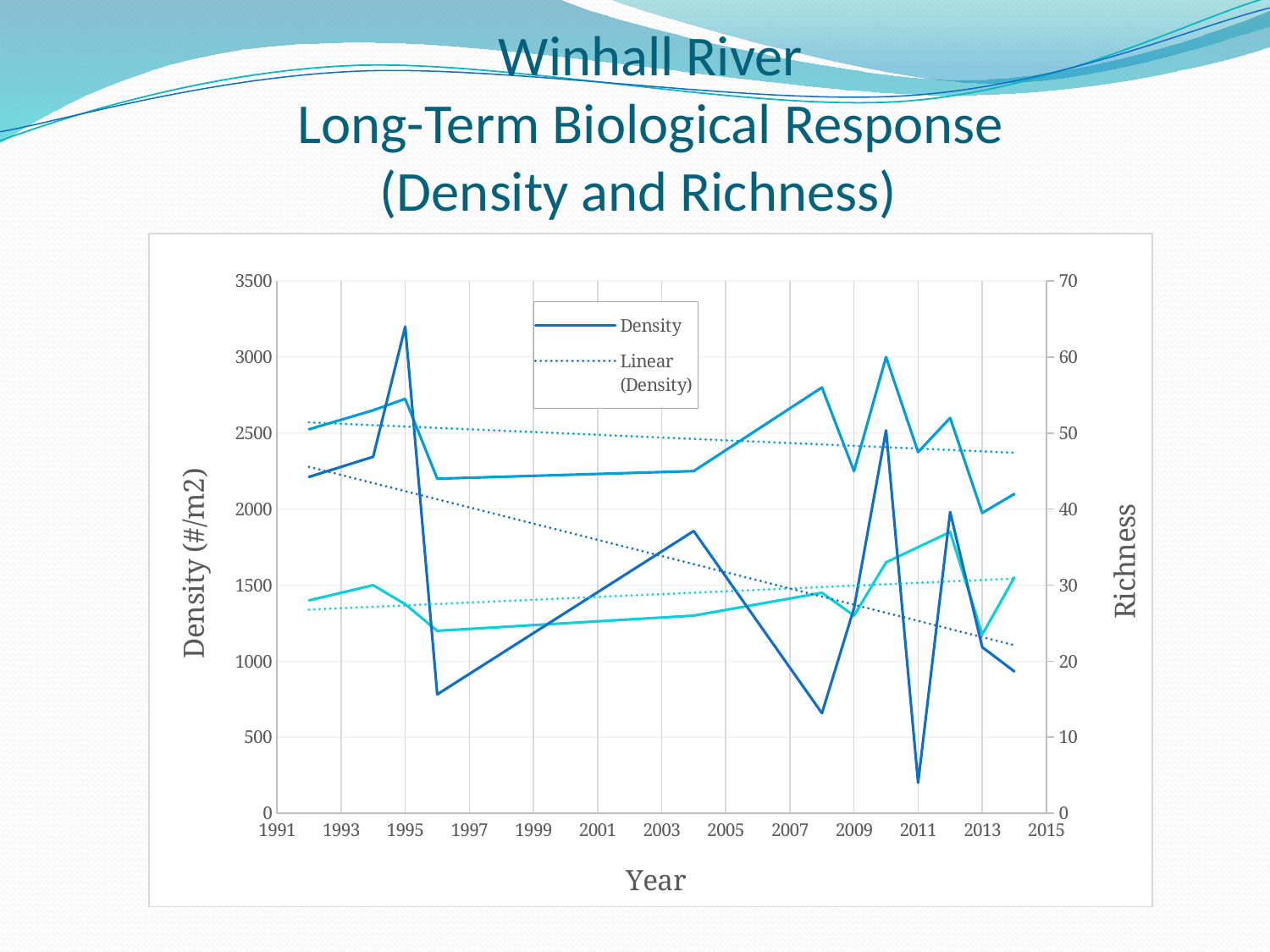
Does the Linear (Density) trend line rise or fall from 1991 to 2015? fall Is the Density value for 1996 greater or less than 1000? less What is the label of the left vertical axis? Density (#/m2) Is the Density value for 2011 greater or less than 500? less In which year does the Density series reach its lowest value? 2011 Which year has the larger Density value, 1995 or 2010? 1995 How many series does the legend list? 2 Is the Density value for 1995 greater or less than 3000? greater What kind of chart is shown on the slide? line chart In which year does the Density series reach its highest value? 1995